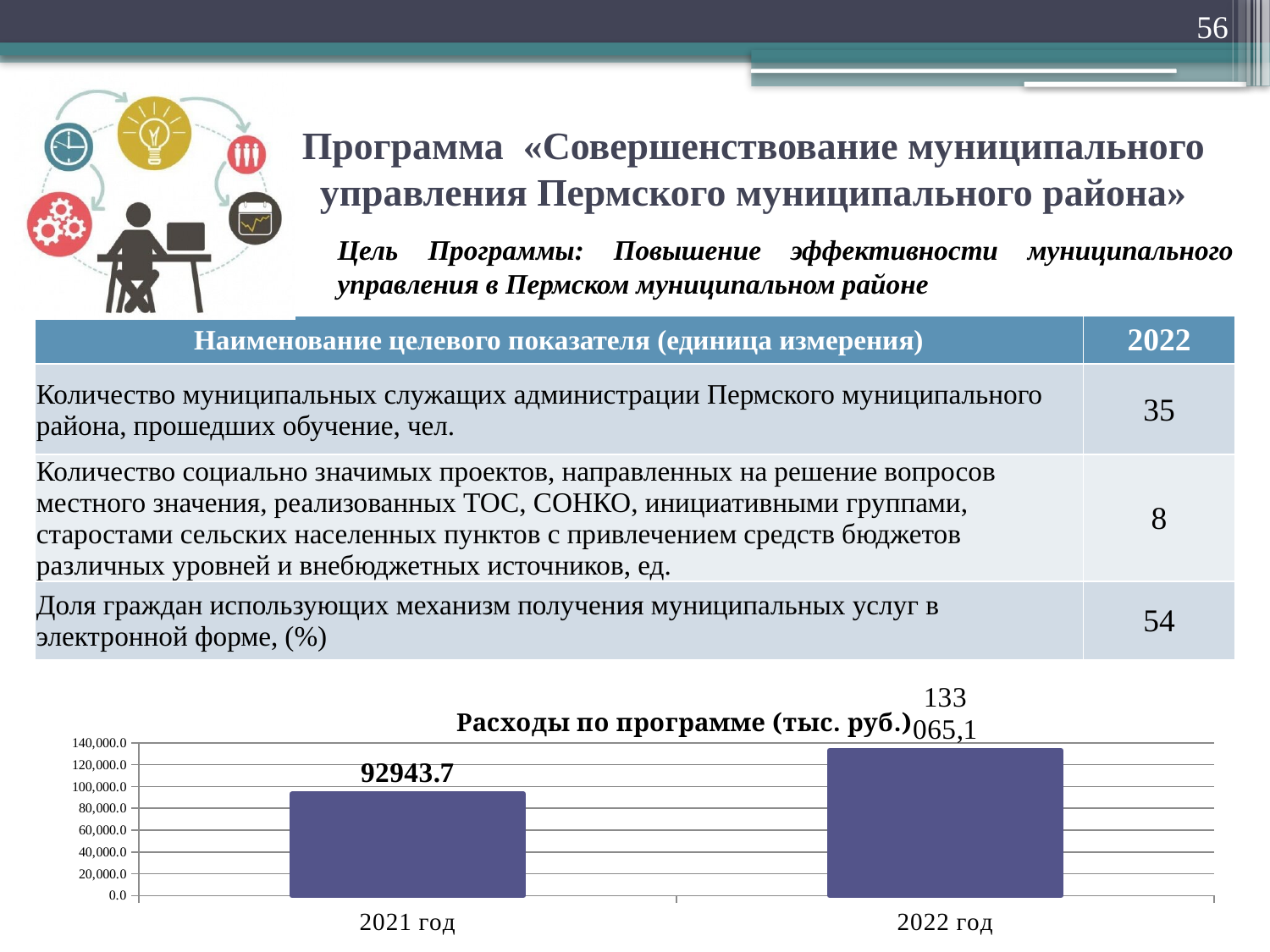
Is the value for 2021 год greater or less than 80,000.0? greater Which year has the lowest value in the chart? 2021 год Which year has the highest value in the chart? 2022 год How many categories are shown on the x axis of the chart? 2 Do the values in the chart rise or fall from 2021 год to 2022 год? rise What is the title of the chart on the slide? Расходы по программе (тыс. руб.) Is the value for 2022 год greater or less than 120,000.0? greater Is the value for 2021 год greater or less than 100,000.0? less What is the highest value shown on the y axis of the chart? 140,000.0 Which is larger in the chart, the value for 2021 год or 2022 год? 2022 год What is the value for 2021 год in the chart? 92943.7 What type of chart is shown on the slide? bar chart